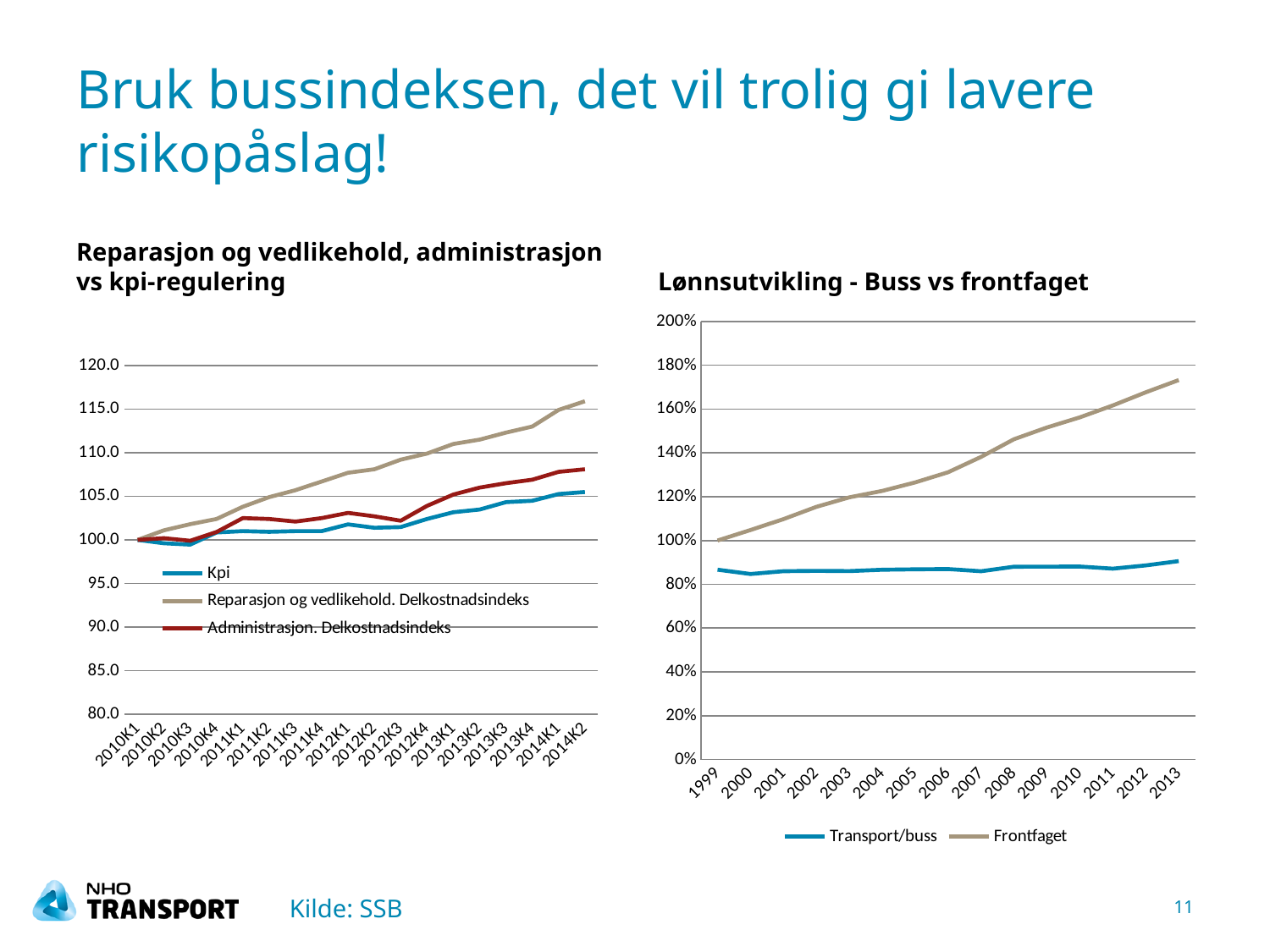
What kind of chart is the 'Lønnsutvikling - Buss vs frontfaget' chart? line chart What kind of chart is the 'Reparasjon og vedlikehold, administrasjon vs kpi-regulering' chart? line chart How many quarters are shown on the x axis of the 'Reparasjon og vedlikehold, administrasjon vs kpi-regulering' chart? 18 How many series does the legend of the 'Reparasjon og vedlikehold, administrasjon vs kpi-regulering' chart list? 3 How many series does the legend of the 'Lønnsutvikling - Buss vs frontfaget' chart list? 2 In the 'Lønnsutvikling - Buss vs frontfaget' chart, which series is higher in 2013, Transport/buss or Frontfaget? Frontfaget How many years are shown on the x axis of the 'Lønnsutvikling - Buss vs frontfaget' chart? 15 In the 'Reparasjon og vedlikehold, administrasjon vs kpi-regulering' chart, is the value for 'Reparasjon og vedlikehold. Delkostnadsindeks' in 2014K2 greater or less than 110.0? greater In the 'Lønnsutvikling - Buss vs frontfaget' chart, does the Frontfaget line rise or fall from 1999 to 2013? rise In the 'Lønnsutvikling - Buss vs frontfaget' chart, is the value for Transport/buss in 2013 greater or less than 100%? less In the 'Reparasjon og vedlikehold, administrasjon vs kpi-regulering' chart, which series is higher in 2014K2, Kpi or 'Reparasjon og vedlikehold. Delkostnadsindeks'? Reparasjon og vedlikehold. Delkostnadsindeks In the 'Lønnsutvikling - Buss vs frontfaget' chart, is the value for Frontfaget in 2013 greater or less than 160%? greater